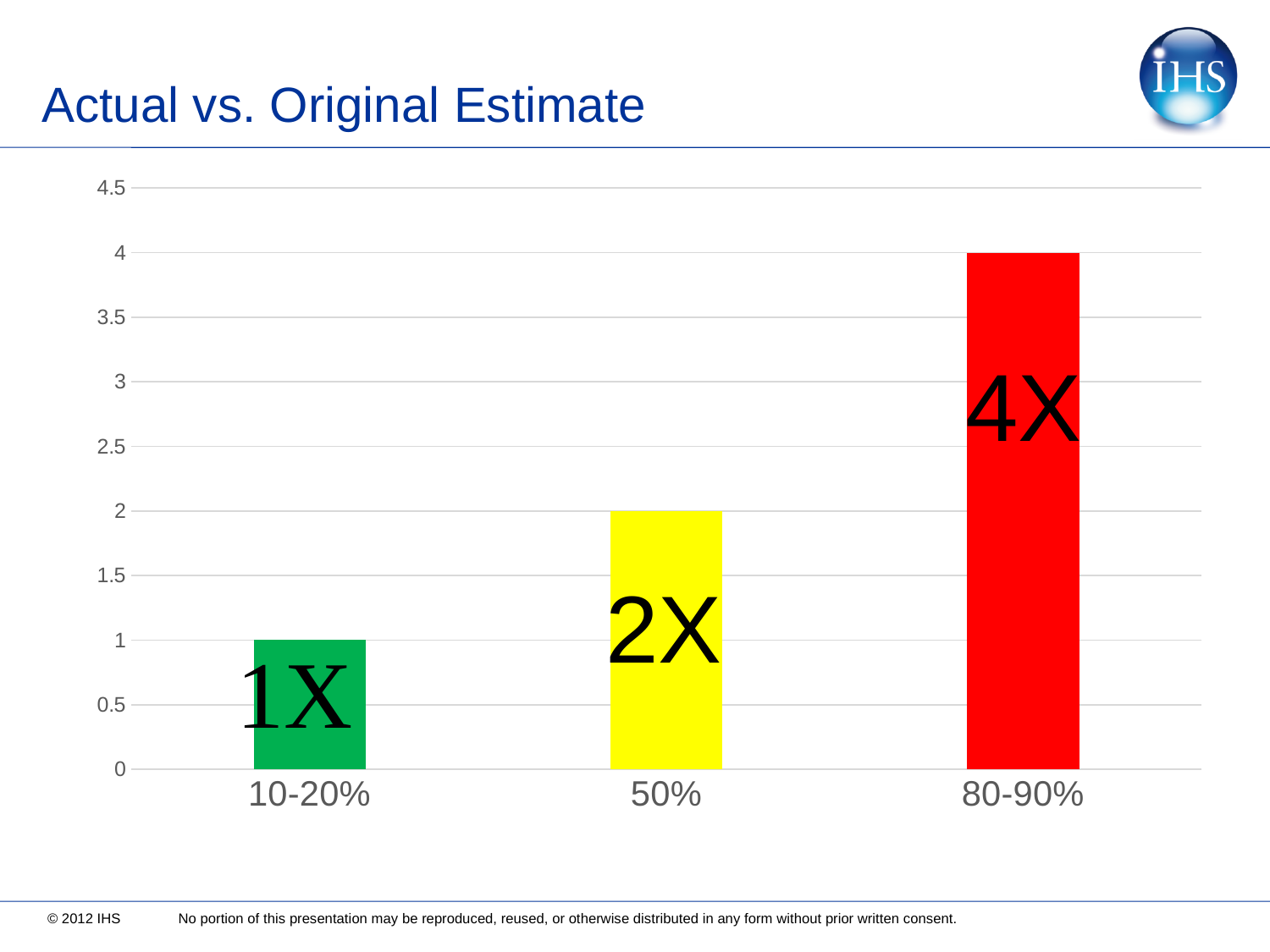
How many bars does the chart show? 3 Which category has the tallest bar? 80-90% Which category has the shortest bar? 10-20% What is the title of the chart? Actual vs. Original Estimate Which bar is taller, the one for 50% or the one for 10-20%? 50% Is the value for 80-90% greater or less than 3? greater What label is printed on the bar for the 50% category? 2X What label is printed on the bar for the 80-90% category? 4X What kind of chart is shown on the slide? bar chart What label is printed on the bar for the 10-20% category? 1X What colour is the bar for the 50% category? yellow Do the bar values rise or fall from left to right across the categories? rise